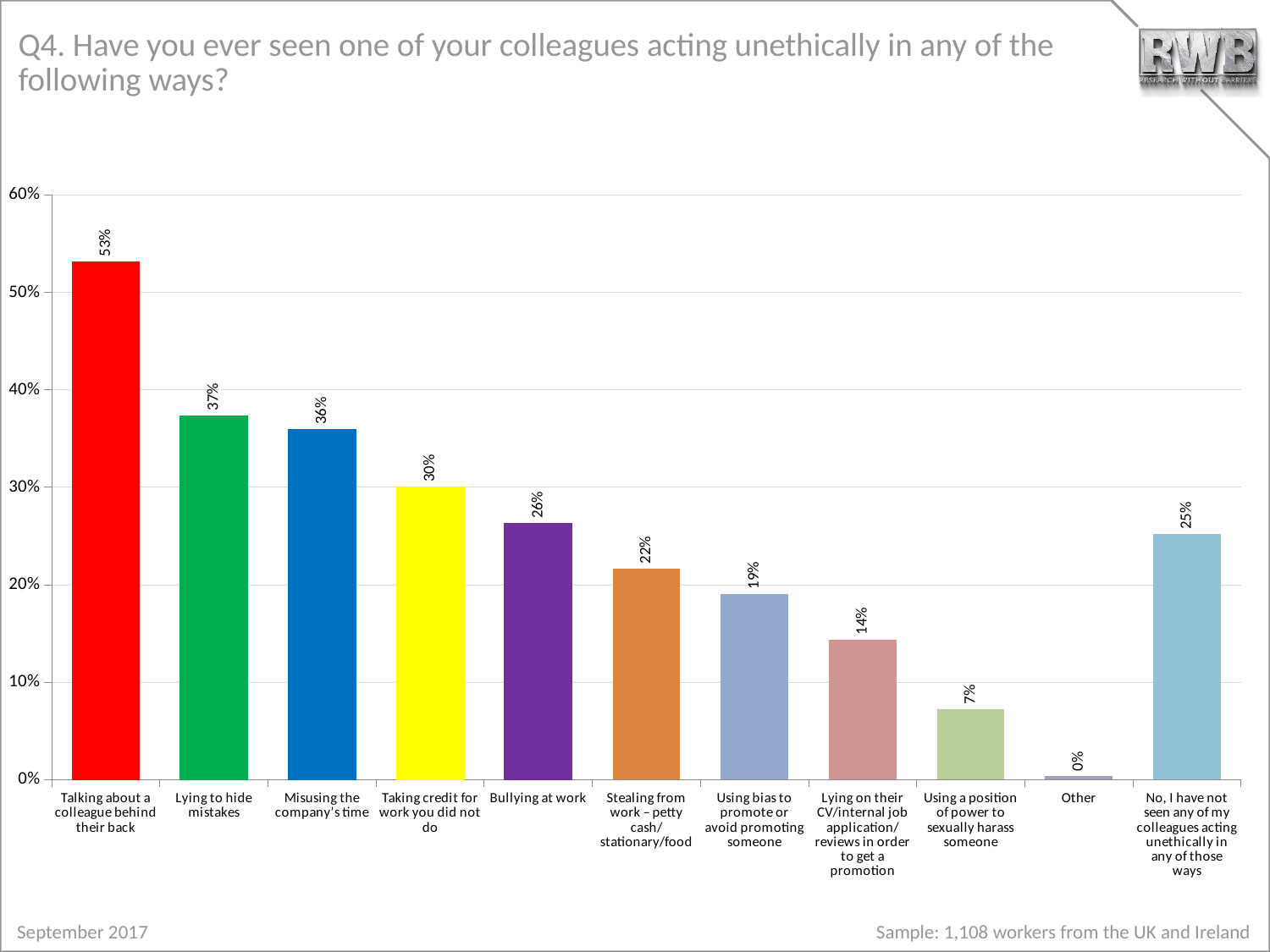
Which category has the highest value? Talking about a colleague behind their back How many categories are shown on the x axis? 11 What kind of chart is shown on the slide? Bar chart What percentage said they have not seen any of their colleagues acting unethically in any of those ways? 25% What percentage of respondents reported seeing a colleague talking about a colleague behind their back? 53% Is the value for 'Taking credit for work you did not do' greater or less than 20%? greater Which category has the lowest value? Other What is the sample size stated at the bottom of the slide? 1,108 workers from the UK and Ireland What is the value for 'Using a position of power to sexually harass someone'? 7% What is the value for 'Bullying at work'? 26% Which is larger: 'Stealing from work – petty cash/stationary/food' or 'Using bias to promote or avoid promoting someone'? Stealing from work – petty cash/stationary/food What is the difference between 'Lying to hide mistakes' and 'Misusing the company's time'? 1%